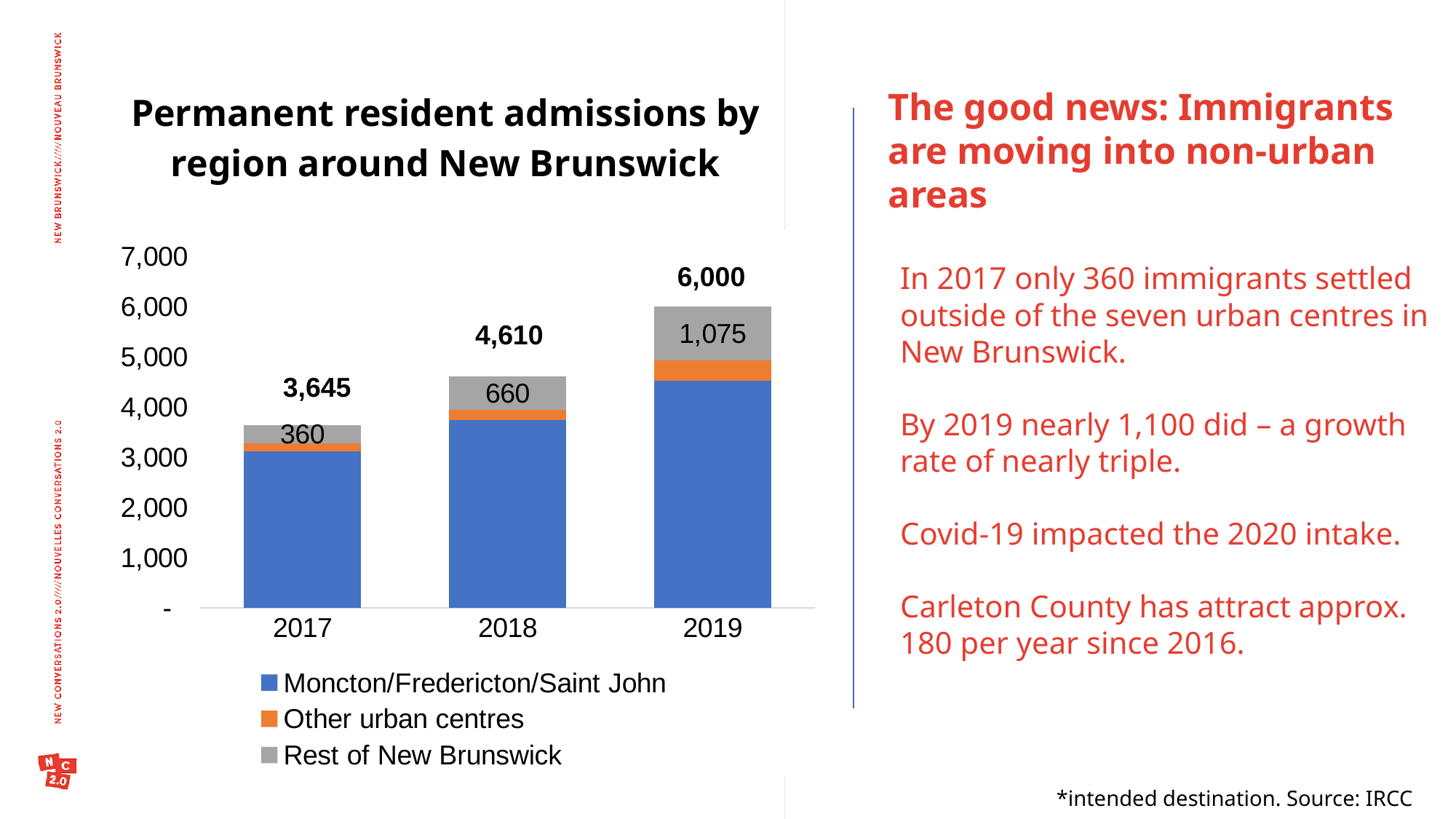
What value is shown for Rest of New Brunswick in 2018? 660 Which year has the lowest total admissions? 2017 What is the total permanent resident admissions shown for 2017? 3,645 Do total admissions rise or fall from 2017 to 2019? Rise Is the value for Moncton/Fredericton/Saint John in 2019 greater or less than 4,000? greater What kind of chart is shown on the slide? Stacked bar chart How many series does the legend list? 3 What value is shown for Rest of New Brunswick in 2019? 1,075 By how much did the Rest of New Brunswick value increase from 2017 to 2019? 715 What is the total permanent resident admissions shown for 2019? 6,000 What is the difference between the total admissions in 2019 and 2017? 2,355 Which year has the highest total admissions? 2019